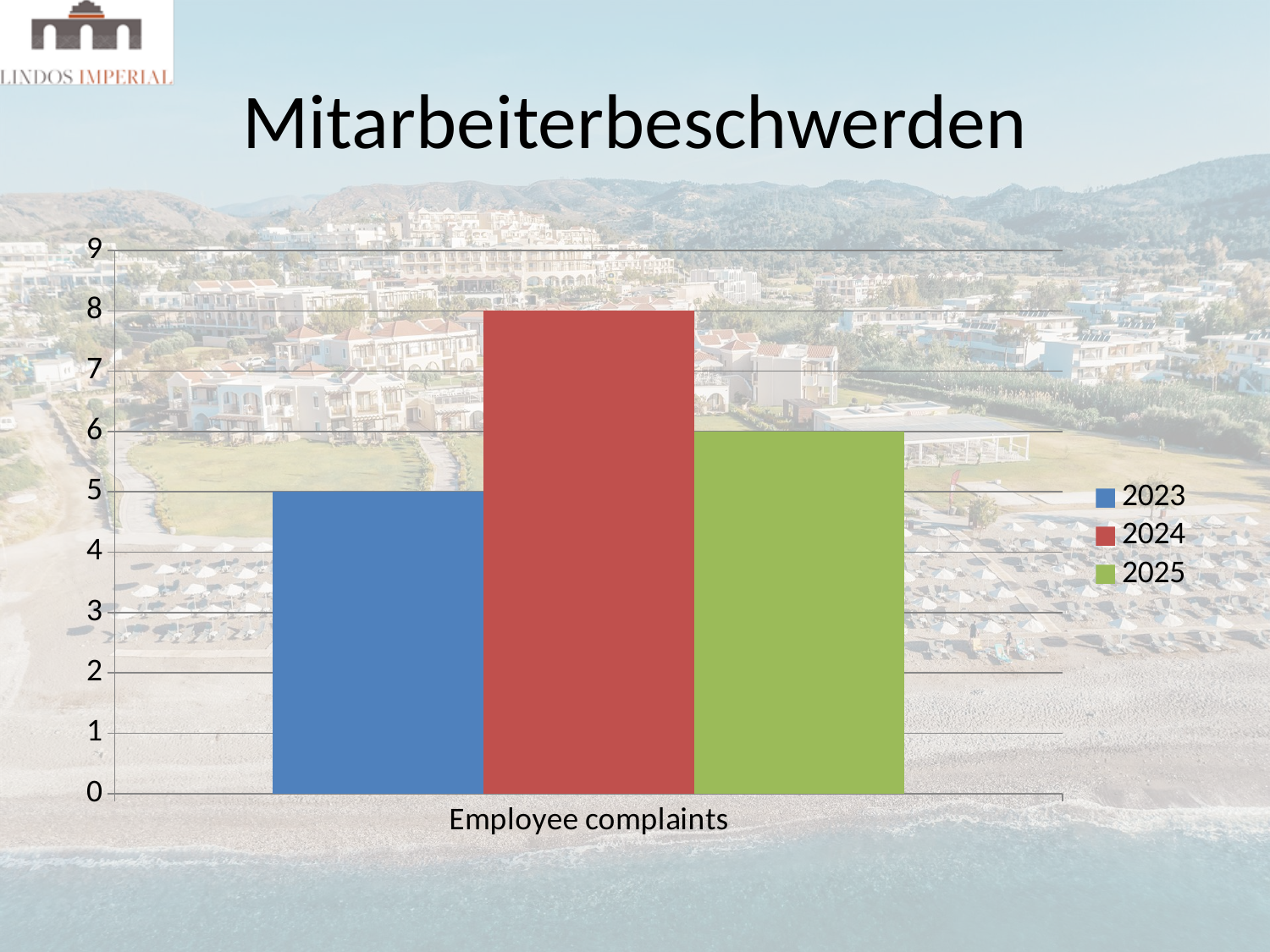
Which is larger, the value for 2025 or the value for 2023? 2025 Which year has the highest number of employee complaints? 2024 What is the difference between the 2024 and 2023 values? 3 What type of chart is shown on the slide? bar chart What is the value for 2023 in the Employee complaints chart? 5 How many series does the legend list? 3 Is the value for 2024 greater or less than 7? greater What is the value for 2024 in the Employee complaints chart? 8 What is the value for 2025 in the Employee complaints chart? 6 What is the title of the slide containing the chart? Mitarbeiterbeschwerden What is the difference between the 2024 and 2025 values? 2 Which year has the lowest number of employee complaints? 2023